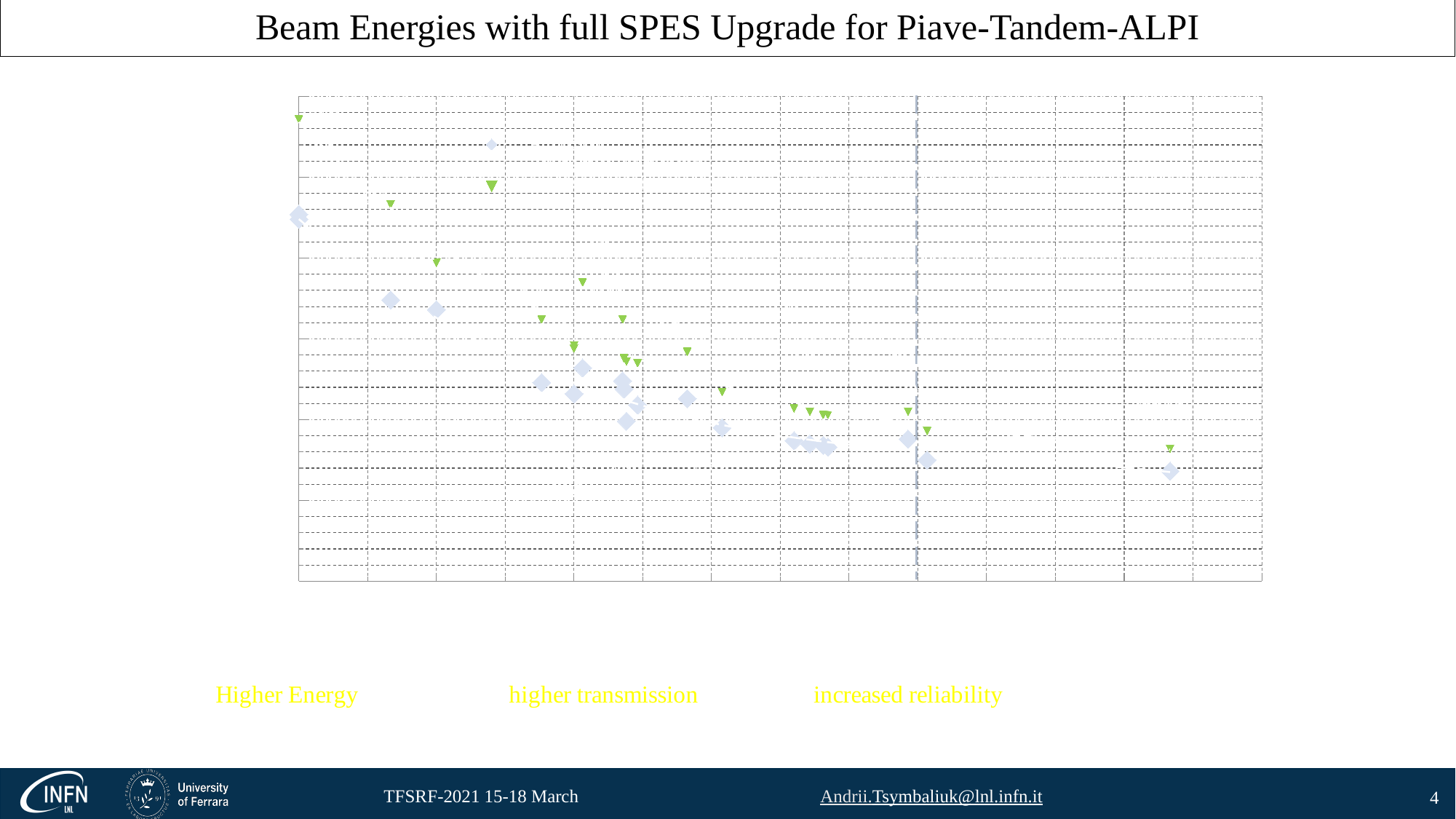
What two marker shapes are used for the plotted points? triangles and diamonds Do the plotted values generally rise or fall moving from left to right along the x axis? fall What colour are the triangle markers in the chart? green What kind of chart is shown on the slide? scatter chart